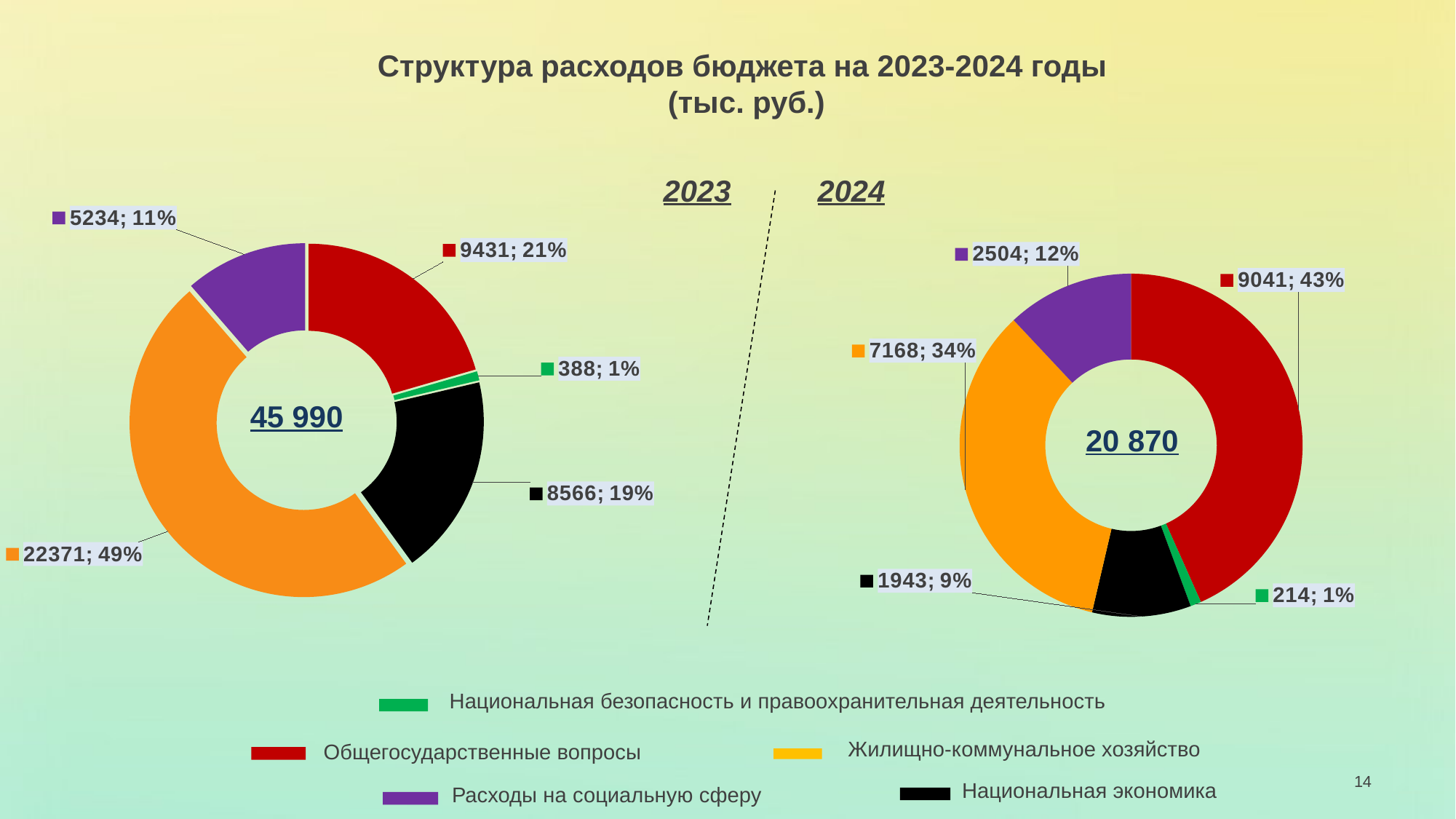
What total is shown in the centre of the 2023 chart? 45 990 In the 2023 chart, which category has the largest share? Жилищно-коммунальное хозяйство What type of chart is used on this slide? Doughnut (pie) chart In the 2024 chart, what value is shown for Общегосударственные вопросы? 9041; 43% In the 2024 chart, what value is shown for Национальная экономика? 1943; 9% In the 2024 chart, which category has the largest share? Общегосударственные вопросы What is the difference between the 2023 and 2024 values for Расходы на социальную сферу? 2730 Which is larger: the 2023 value for Национальная экономика or the 2023 value for Общегосударственные вопросы? Общегосударственные вопросы In the 2024 chart, which category has the smallest share? Национальная безопасность и правоохранительная деятельность What share of the 2024 chart does Жилищно-коммунальное хозяйство represent? 34% In the 2023 chart, what value is shown for Жилищно-коммунальное хозяйство? 22371; 49% How many categories does the legend list? 5